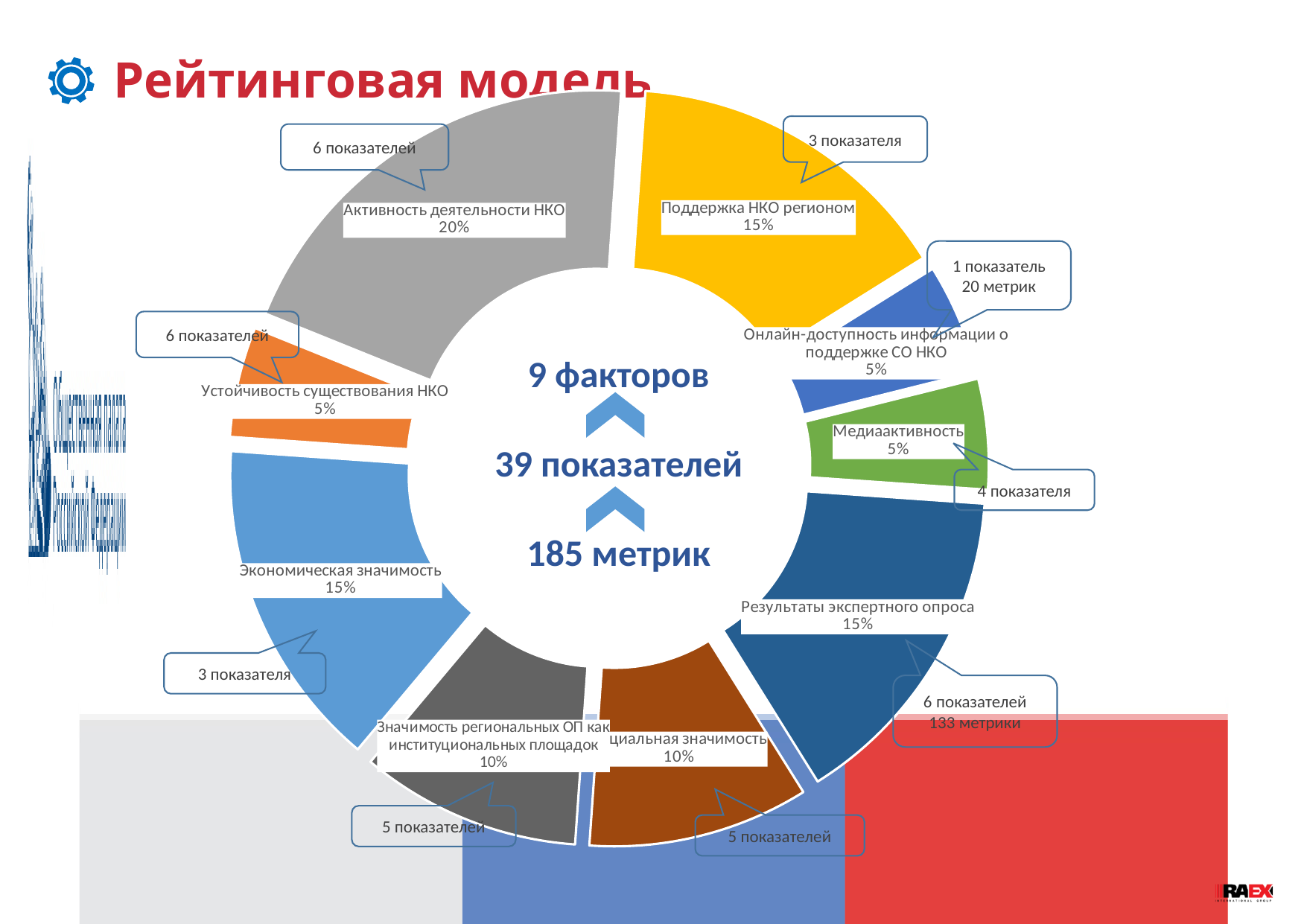
What is the difference between the shares of "Активность деятельности НКО" and "Экономическая значимость"? 5% What share does "Результаты экспертного опроса" have? 15% What kind of chart is shown on the slide? doughnut chart Which factor has the largest share in the chart? Активность деятельности НКО How many indicators (показателей) does the callout for "Результаты экспертного опроса" list? 6 показателей Which has the larger share: "Экономическая значимость" or "Значимость региональных ОП как институциональных площадок"? Экономическая значимость What share does "Устойчивость существования НКО" have? 5% What total number of metrics is stated in the centre of the chart? 185 метрик What share does "Активность деятельности НКО" have in the chart? 20% What share does "Поддержка НКО регионом" have? 15% How many factors (segments) does the chart show? 9 What share does "Медиаактивность" have? 5%